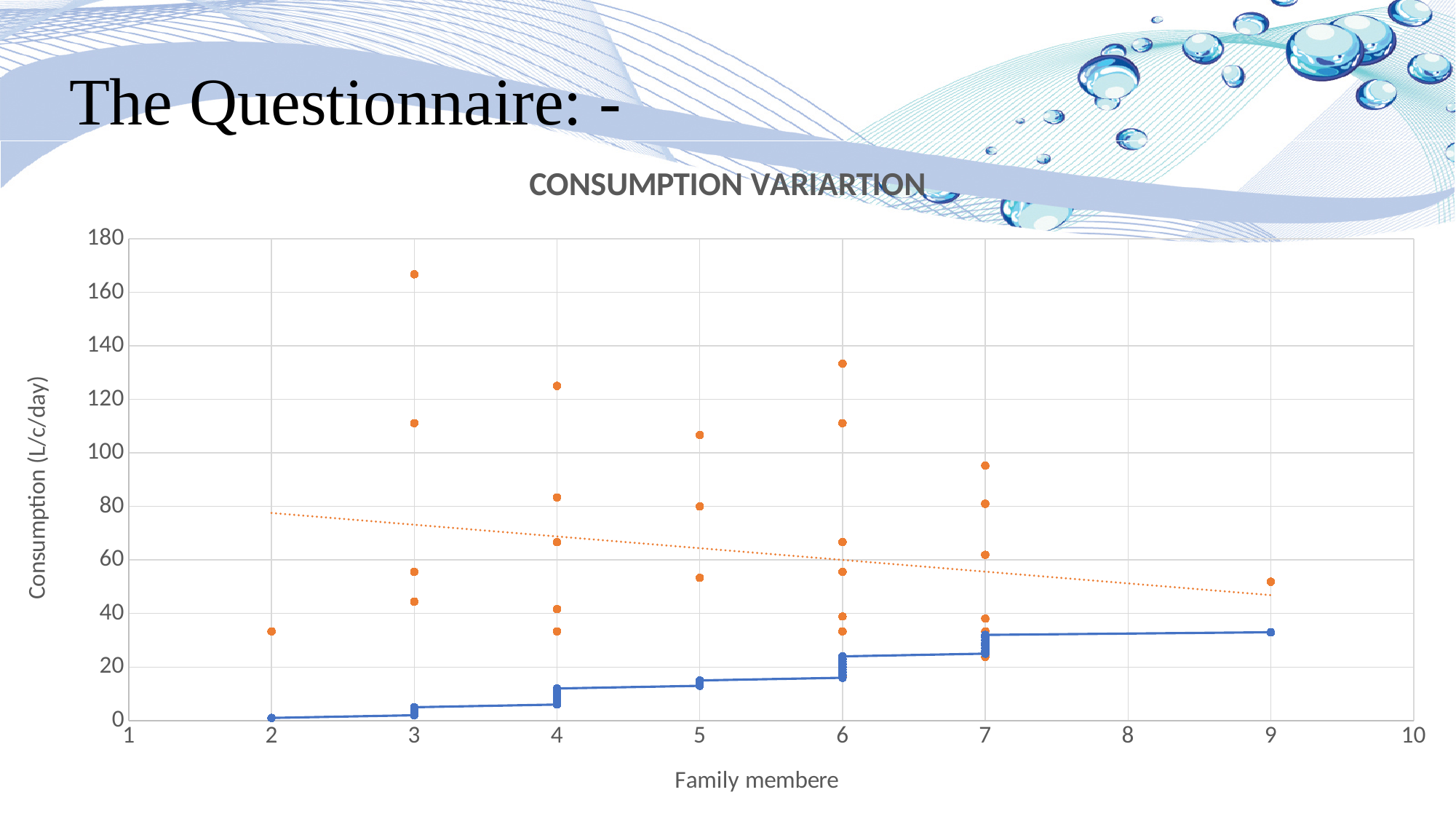
At which number of family members does the highest orange point on the chart appear? 3 How many orange points are plotted at 5 family members? 3 Is the orange point at 2 family members greater or less than 40? less What kind of chart is shown on the slide? scatter chart Is the highest orange point at 3 family members greater or less than 160? greater What is the title of the chart? CONSUMPTION VARIARTION Is the orange point at 9 family members greater or less than 40? greater What is the label on the vertical axis of the chart? Consumption (L/c/day) Does the orange dotted trend line rise or fall as the number of family members increases? falls Does the blue series rise or fall as the number of family members increases? rises